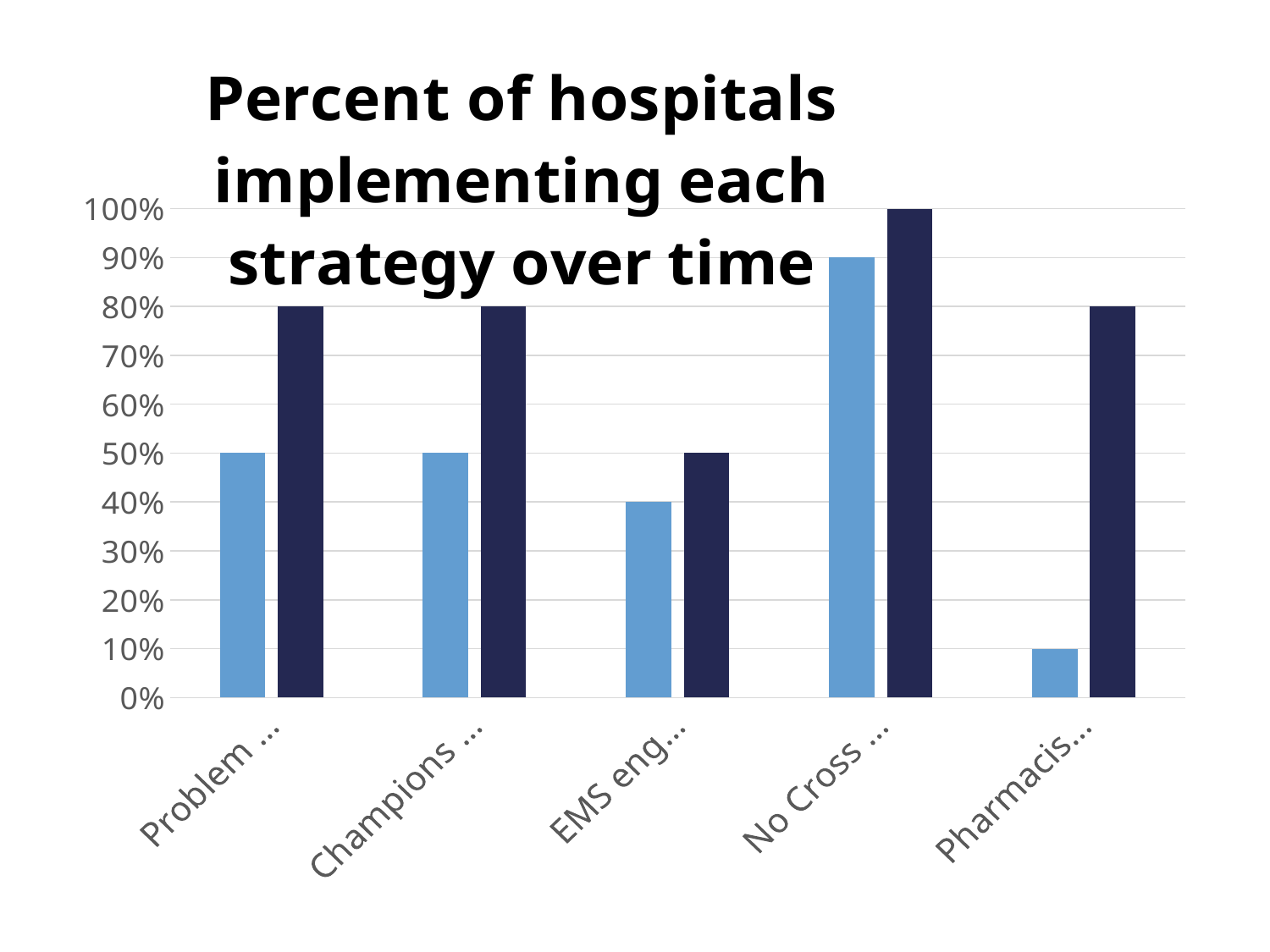
Which category has the highest light blue bar? No Cross ... Which category has the lowest light blue bar? Pharmacis... What is the difference between the dark navy bar and the light blue bar for the fifth category (label beginning "Pharmacis")? 70% What is the value of the light blue bar for the third category (label beginning "EMS eng")? 40% What kind of chart is shown on the slide? bar chart What is the value of the dark navy bar for the fourth category (label beginning "No Cross")? 100% For the third category (label beginning "EMS eng"), which bar is larger, the light blue or the dark navy? dark navy What is the value of the light blue bar for the fifth category (label beginning "Pharmacis")? 10% Is the light blue bar for the fourth category (label beginning "No Cross") greater or less than 80%? greater What is the title of the chart? Percent of hospitals implementing each strategy over time What is the value of the dark navy bar for the first category (label beginning "Problem")? 80% How many categories are shown along the x axis of the chart? 5